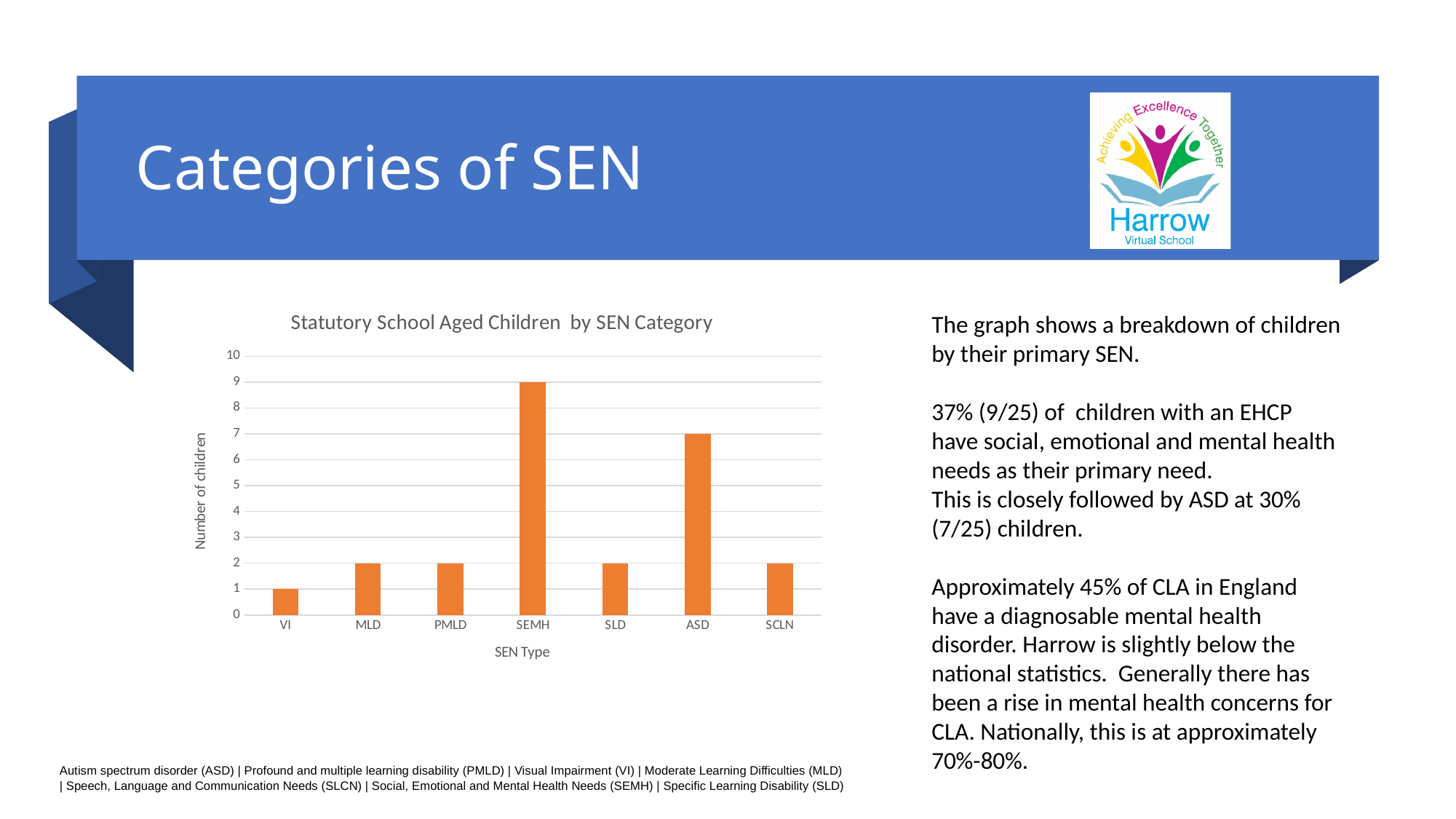
How many children are in the VI category? 1 Which SEN category has the highest number of children? SEMH What type of chart is shown on the slide? bar chart How many children are in the ASD category? 7 Is the value for SEMH greater or less than 5? greater Which SEN category has the lowest number of children? VI What is the difference between the number of children in the SEMH category and the ASD category? 2 How many children are in the SEMH category? 9 What is the label of the y axis of the chart? Number of children Which has more children, the MLD category or the ASD category? ASD What is the title of the chart? Statutory School Aged Children by SEN Category How many SEN categories are shown on the x axis of the chart? 7